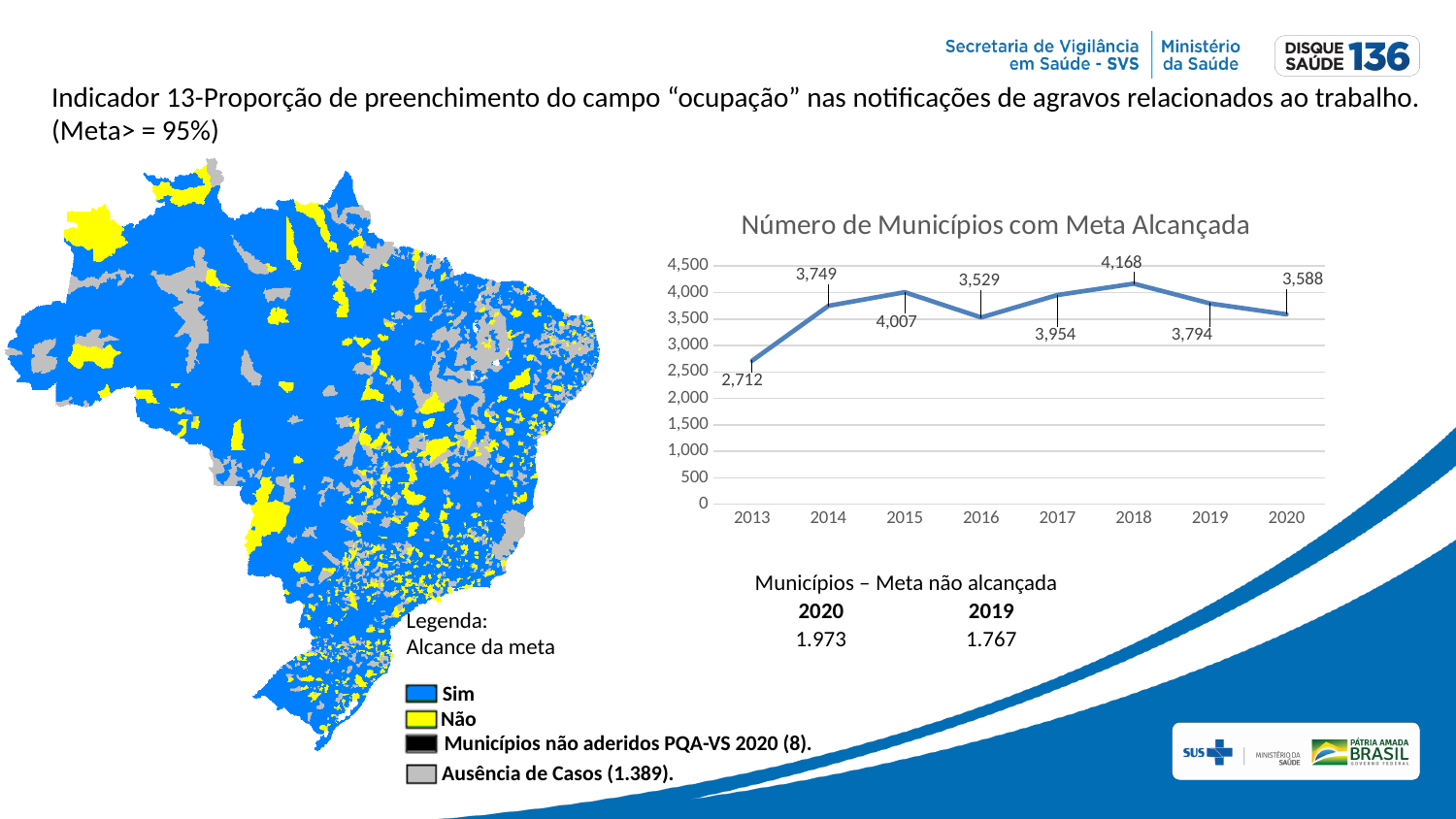
What is the title of the line chart on the slide? Número de Municípios com Meta Alcançada In the chart 'Número de Municípios com Meta Alcançada', what is the value for 2020? 3,588 In the chart 'Número de Municípios com Meta Alcançada', which is larger, the value for 2015 or the value for 2016? 2015 In the chart 'Número de Municípios com Meta Alcançada', which year has the lowest value? 2013 In the chart 'Número de Municípios com Meta Alcançada', is the value for 2014 greater or less than 3,500? greater How many years are plotted in the chart 'Número de Municípios com Meta Alcançada'? 8 In the chart 'Número de Municípios com Meta Alcançada', what is the value for 2013? 2,712 In the chart 'Número de Municípios com Meta Alcançada', what is the difference between the values for 2019 and 2020? 206 In the chart 'Número de Municípios com Meta Alcançada', what is the difference between the values for 2018 and 2013? 1,456 What kind of chart is 'Número de Municípios com Meta Alcançada'? line chart In the chart 'Número de Municípios com Meta Alcançada', what is the value for 2018? 4,168 In the chart 'Número de Municípios com Meta Alcançada', which year has the highest value? 2018